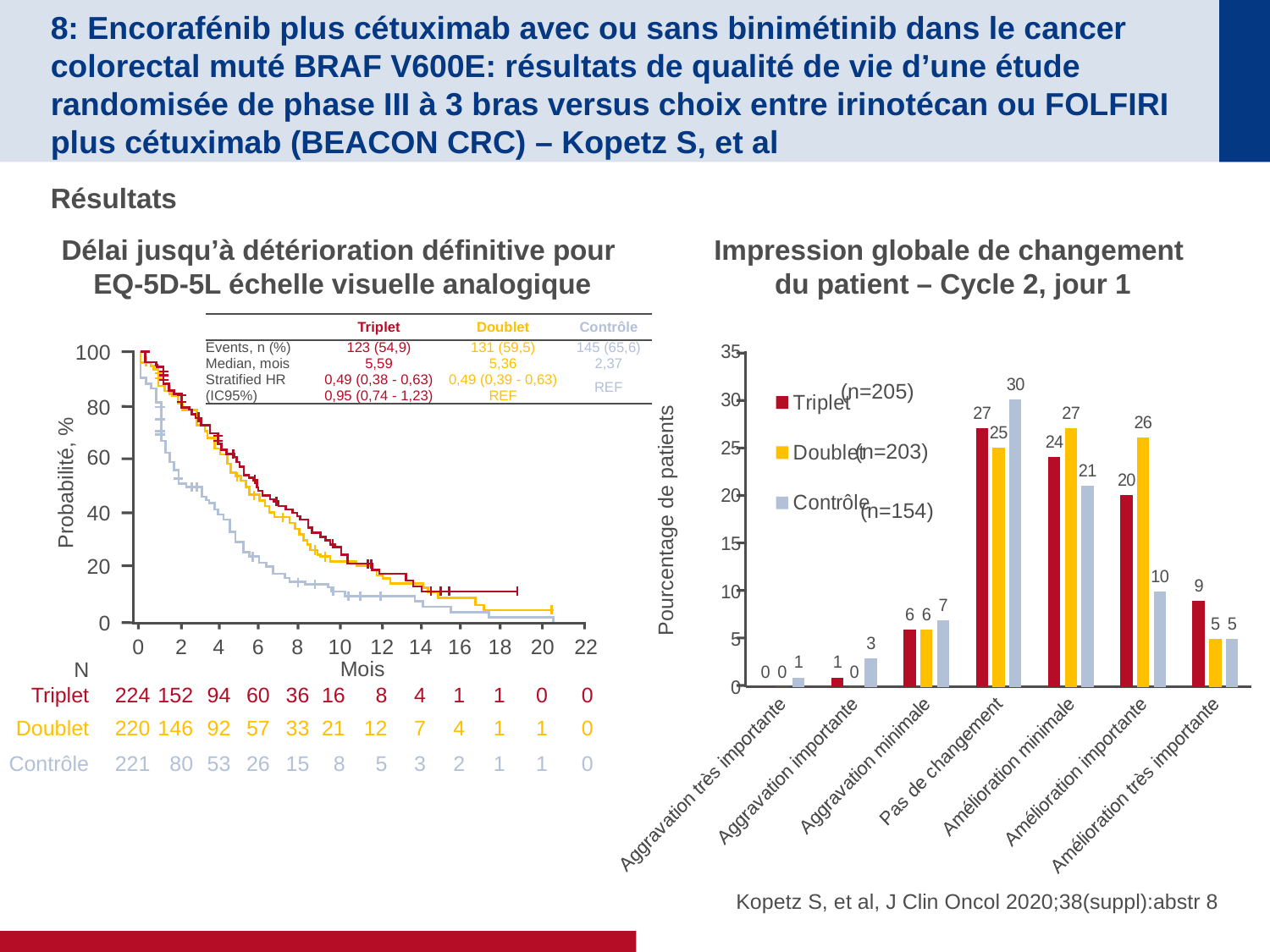
In the 'Impression globale de changement du patient' chart, which series has the highest value for 'Pas de changement'? Contrôle In the 'Délai jusqu'à détérioration définitive' chart, do the probability curves rise or fall as months increase? fall In the 'Impression globale de changement du patient' chart, what is the value for Contrôle in the 'Amélioration importante' category? 10 What kind of chart is the 'Impression globale de changement du patient' chart? bar chart How many series does the legend of the 'Impression globale de changement du patient' chart list? 3 In the 'Impression globale de changement du patient' chart, what percentage of Triplet patients reported 'Pas de changement'? 27 In the 'Impression globale de changement du patient' chart, is the Triplet value for 'Amélioration très importante' larger or smaller than the Doublet value? larger In the 'Impression globale de changement du patient' chart, what is the difference between the Doublet and Contrôle values for 'Amélioration importante'? 16 In the 'Délai jusqu'à détérioration définitive' chart, what is the median in months for the Contrôle group? 2,37 In the 'Délai jusqu'à détérioration définitive' chart, how many Triplet patients were at risk at month 0? 224 How many categories are shown on the x axis of the 'Impression globale de changement du patient' chart? 7 In the 'Impression globale de changement du patient' chart, what is the sample size (n) given for the Contrôle group in the legend? n=154